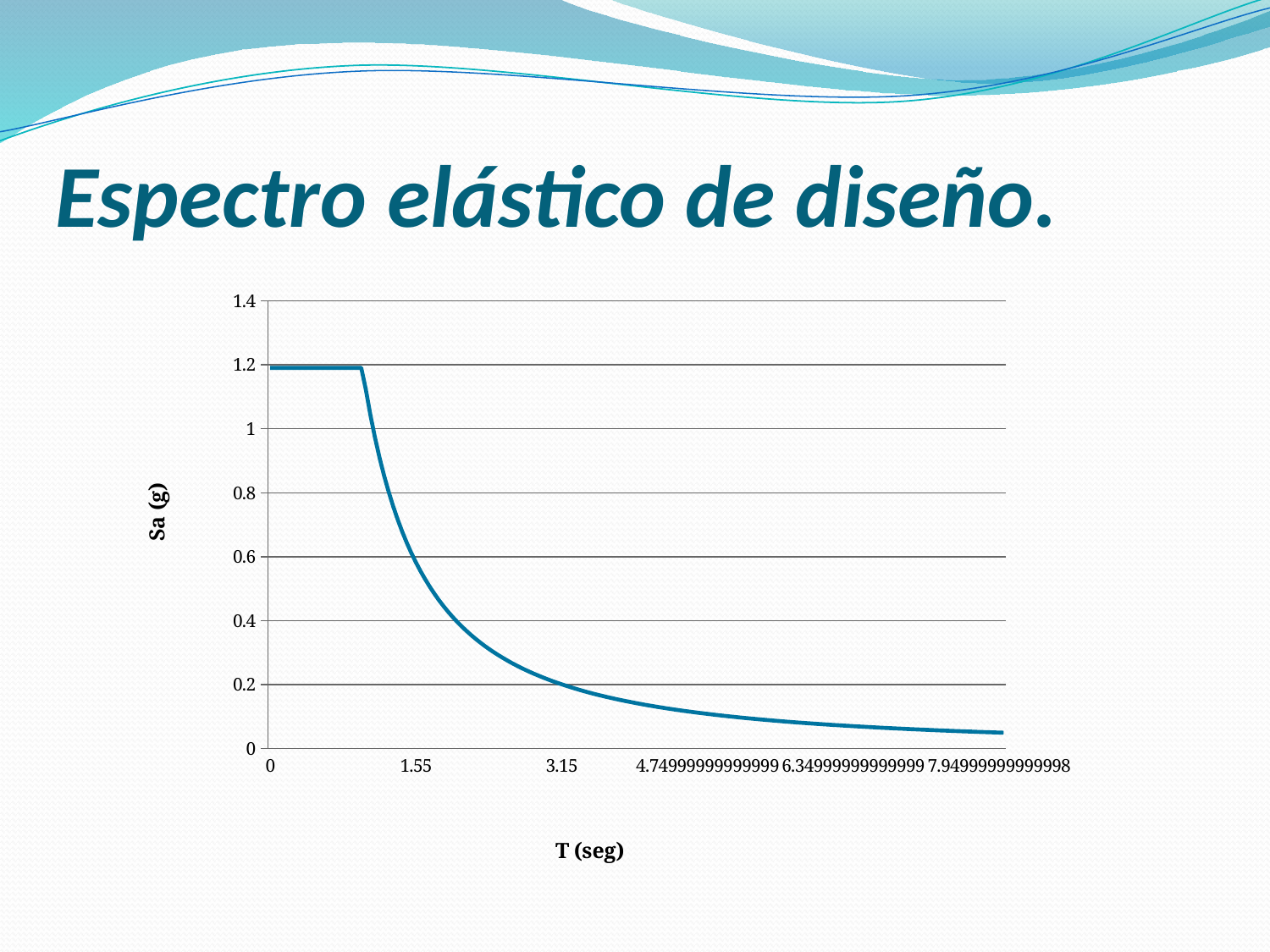
Is the value of Sa at T = 4.75 greater or less than 0.2? less Is the highest value of Sa found at the left end or the right end of the x axis? left end Is the value of Sa at T = 0 greater or less than 1? greater Is the value of Sa at T = 0 larger or smaller than the value at T = 3.15? larger What is the highest tick value shown on the vertical axis? 1.4 What is the title of the slide containing the chart? Espectro elástico de diseño. What is the label of the vertical axis of the chart? Sa (g) Is the value of Sa at T = 1.55 greater or less than 0.4? greater Does the plotted value rise or fall as T increases beyond about 1 second? fall What kind of chart is shown on the slide? line chart